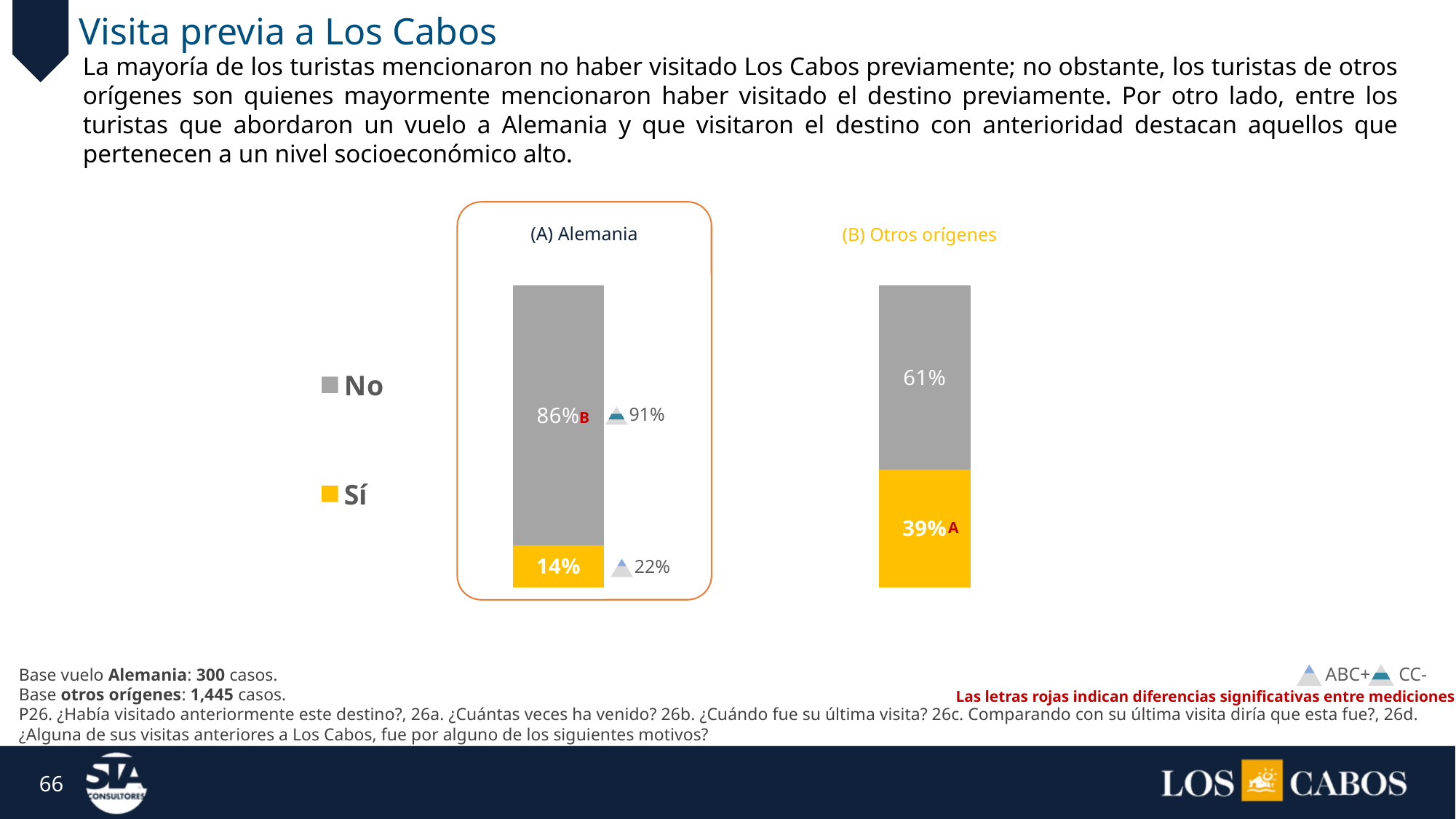
What percentage of tourists from (A) Alemania said "Sí" to having previously visited Los Cabos? 14% What kind of chart is shown on the slide? Stacked bar chart What is the total of the stacked bar for (A) Alemania? 100% What is the difference between the "No" percentages for (A) Alemania and (B) Otros orígenes? 25 percentage points How many bars (groups) are shown in the chart? 2 Which colour represents the "Sí" series in the chart? Yellow What percentage of tourists from (B) Otros orígenes said "Sí"? 39% How many series does the legend list? 2 What percentage of tourists from (B) Otros orígenes said "No"? 61% What percentage of tourists from (A) Alemania said "No" to having previously visited Los Cabos? 86% What is the difference between the "Sí" percentages for (B) Otros orígenes and (A) Alemania? 25 percentage points Which group has the higher share of "Sí" responses, (A) Alemania or (B) Otros orígenes? (B) Otros orígenes